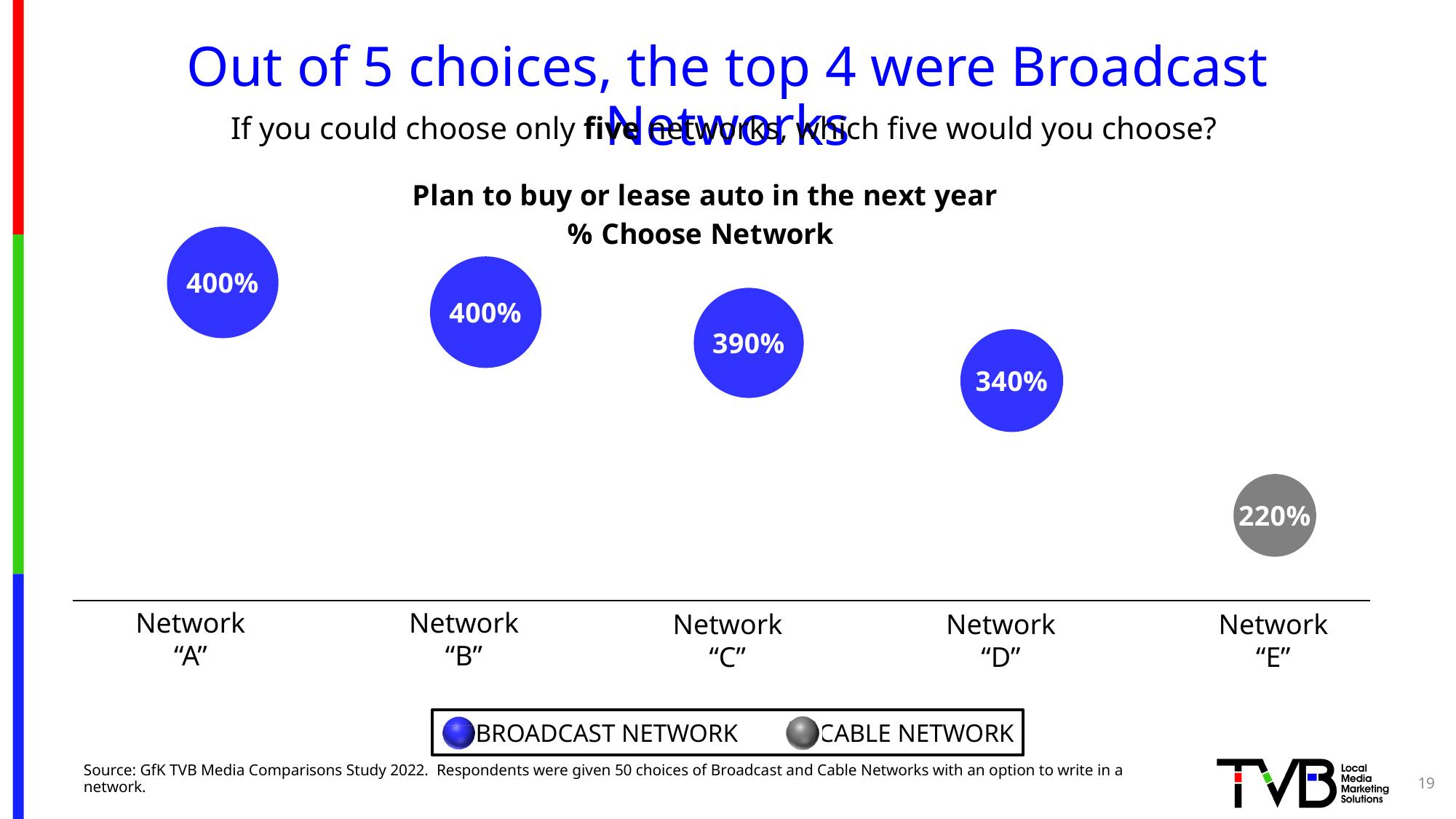
What is the difference between the values for Network "A" and Network "E"? 180% Do the values rise or fall from Network "A" to Network "E"? fall How many networks are shown in the chart? 5 What is the value for Network "D"? 340% Which has a larger value, Network "D" or Network "E"? Network "D" What is the value for Network "C"? 390% What is the value for Network "E"? 220% What is the value for Network "A"? 400% Which network has the lowest value? Network "E" What is the difference between the values for Network "C" and Network "D"? 50% Which network is shown as a Cable Network in the chart? Network "E" What is the highest value shown in the chart? 400%